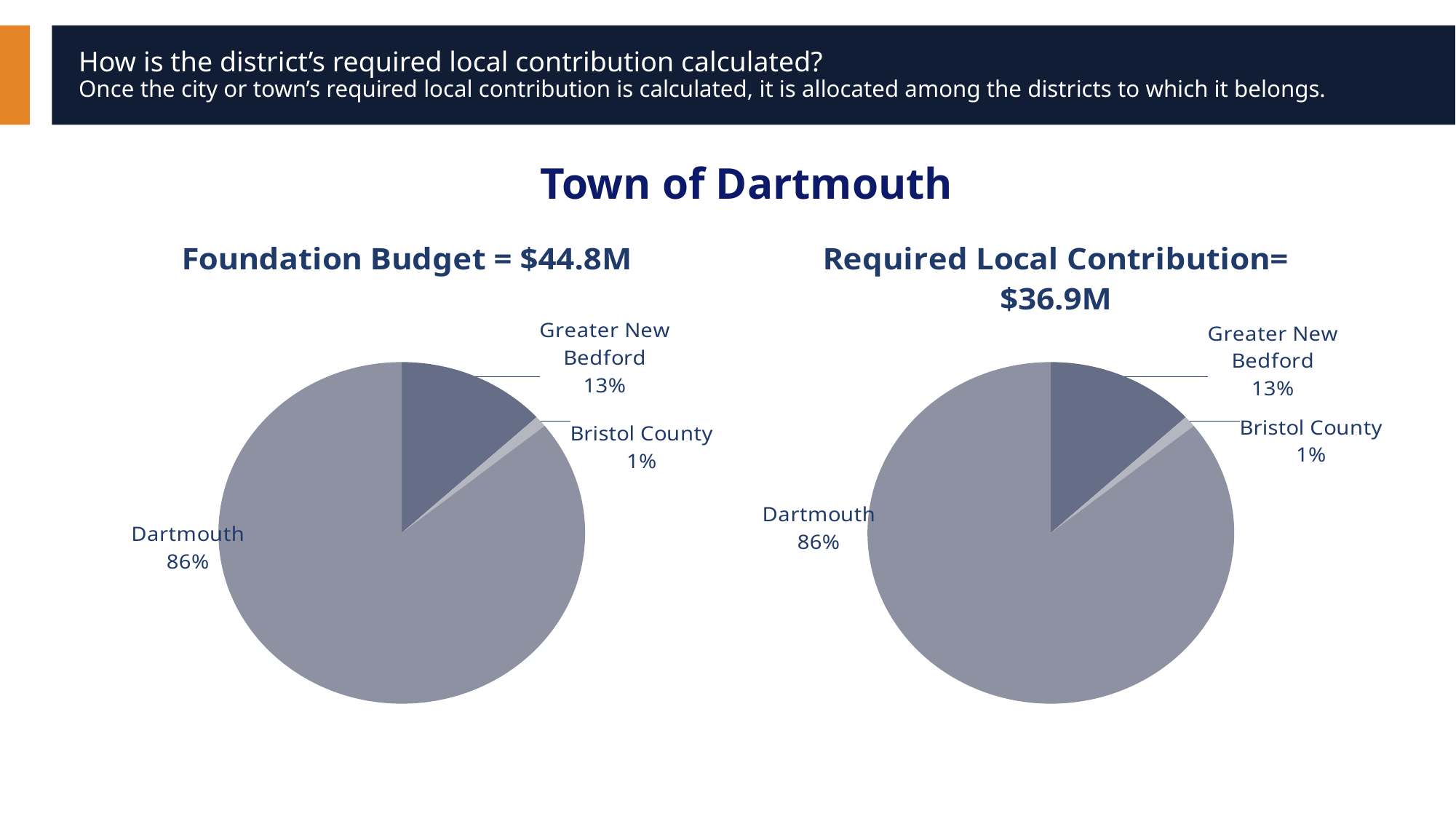
In the Foundation Budget = $44.8M chart, what share of the pie does Greater New Bedford have? 13% In the Foundation Budget = $44.8M chart, which category has the largest slice? Dartmouth In the Required Local Contribution= $36.9M chart, which is larger, Greater New Bedford or Bristol County? Greater New Bedford What is the title of the right chart on the slide? Required Local Contribution= $36.9M What type of chart is the Required Local Contribution= $36.9M chart? Pie chart In the Foundation Budget = $44.8M chart, what share of the pie does Dartmouth have? 86% What is the title of the left chart on the slide? Foundation Budget = $44.8M In the Foundation Budget = $44.8M chart, what is the difference in percentage points between Dartmouth and Greater New Bedford? 73 How many slices does the Foundation Budget = $44.8M pie chart have? 3 In the Required Local Contribution= $36.9M chart, which category has the smallest slice? Bristol County In the Required Local Contribution= $36.9M chart, what share of the pie does Bristol County have? 1%